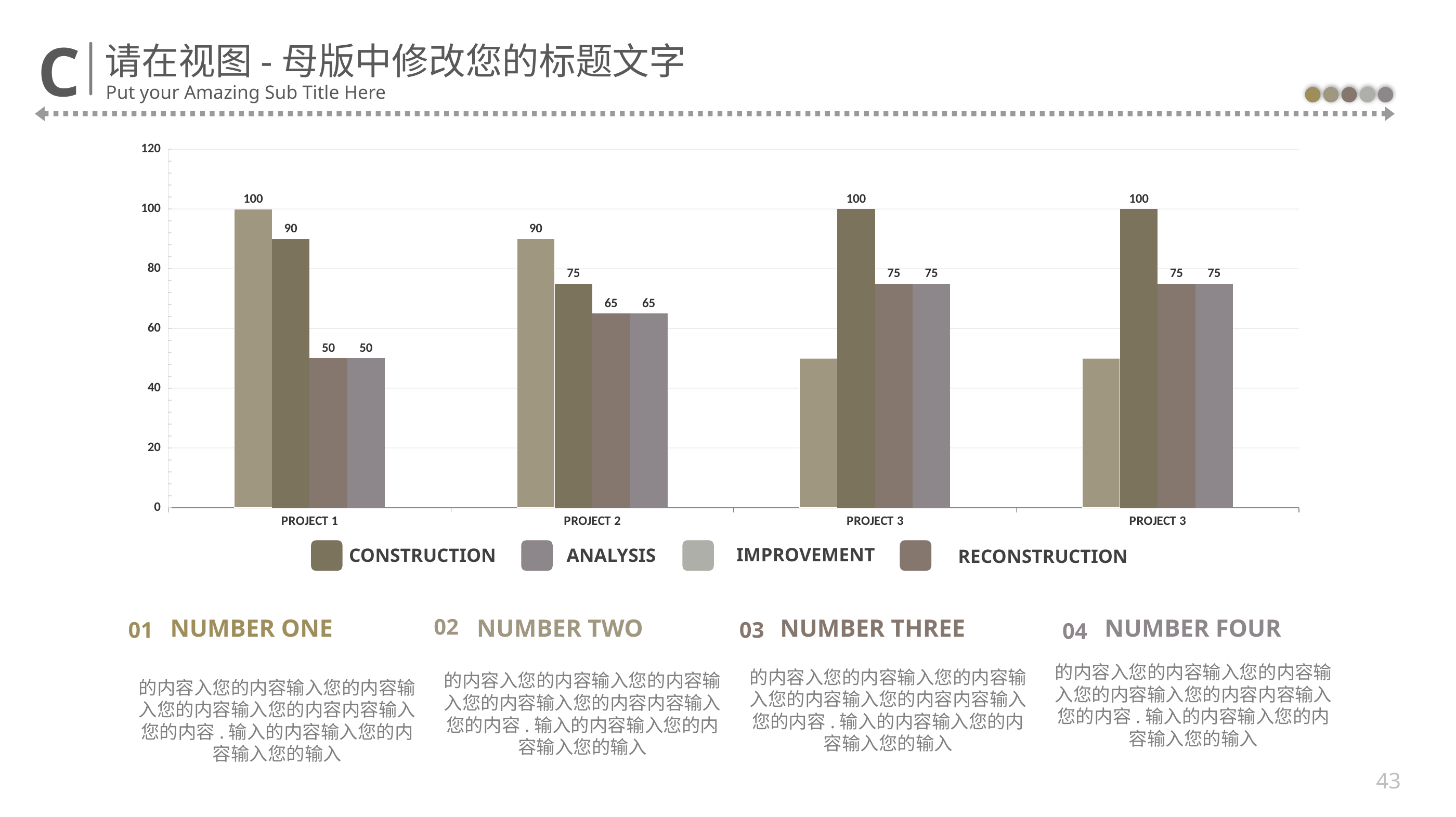
Is the IMPROVEMENT value in the third group (PROJECT 3) greater or less than 60? less How many category groups are plotted along the x axis? 4 Which is larger, the CONSTRUCTION value for PROJECT 1 or for PROJECT 2? PROJECT 1 What is the IMPROVEMENT value for PROJECT 2? 90 Which series has the highest value in the PROJECT 1 group? IMPROVEMENT What is the difference between the IMPROVEMENT and ANALYSIS values for PROJECT 1? 50 How many series does the chart legend list? 4 What kind of chart is shown on the slide? bar chart What is the ANALYSIS value for PROJECT 2? 65 What is the CONSTRUCTION value for PROJECT 1? 90 What is the difference between the CONSTRUCTION and RECONSTRUCTION values for PROJECT 2? 10 Do the IMPROVEMENT values rise or fall from PROJECT 1 to PROJECT 2? fall